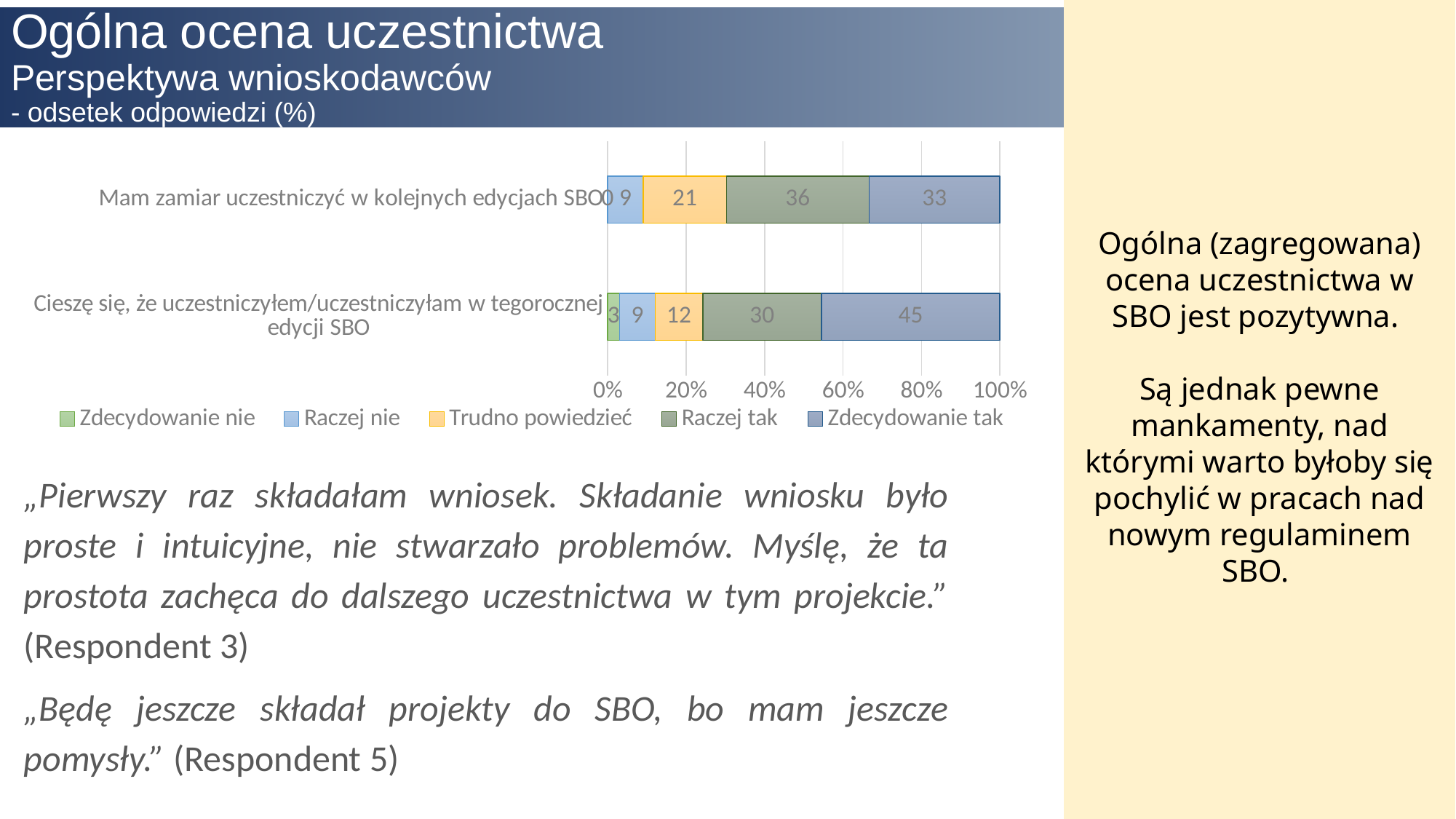
What is the value of "Trudno powiedzieć" for "Mam zamiar uczestniczyć w kolejnych edycjach SBO"? 21 How many categories (bars) are plotted in the chart? 2 Which series has the largest value in the bar for "Mam zamiar uczestniczyć w kolejnych edycjach SBO"? Raczej tak What is the value of "Raczej tak" for "Cieszę się, że uczestniczyłem/uczestniczyłam w tegorocznej edycji SBO"? 30 What kind of chart is shown on the slide? stacked bar chart What colour represents "Trudno powiedzieć" in the chart? yellow What is the value of "Zdecydowanie nie" for "Cieszę się, że uczestniczyłem/uczestniczyłam w tegorocznej edycji SBO"? 3 How many series does the legend list? 5 What is the difference between the "Zdecydowanie tak" values of the two categories? 12 What is the difference between the "Trudno powiedzieć" values of the two categories? 9 Which category has the higher value for "Zdecydowanie tak"? Cieszę się, że uczestniczyłem/uczestniczyłam w tegorocznej edycji SBO What is the value of "Zdecydowanie tak" for "Mam zamiar uczestniczyć w kolejnych edycjach SBO"? 33